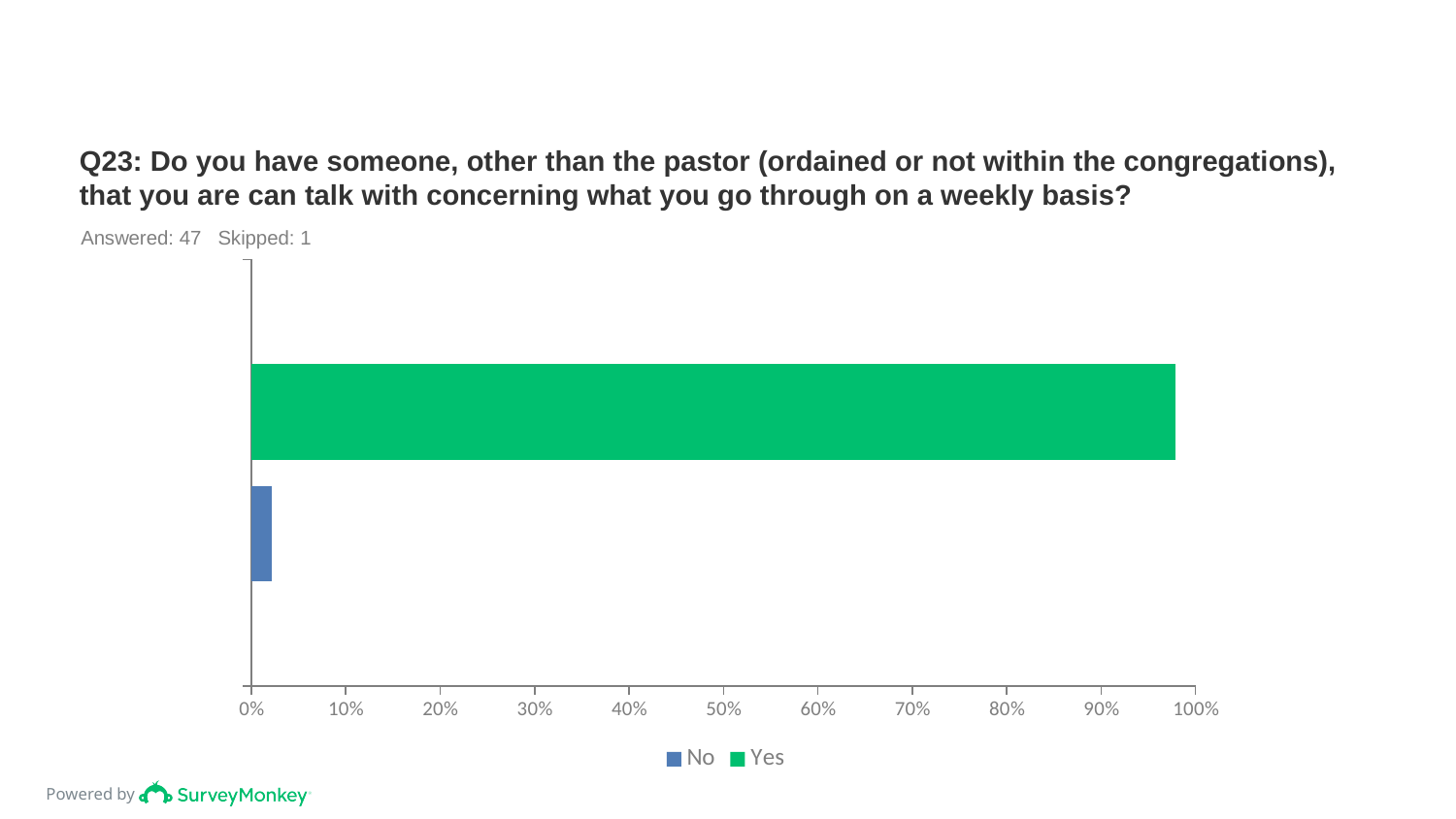
Is the value for Yes greater or less than 90%? greater Which series has the shortest bar, No or Yes? No Is the value for Yes greater or less than 50%? greater How many respondents answered this question according to the slide? 47 What colour is the bar for the Yes series? green Is the bar for Yes longer or shorter than the bar for No? longer What kind of chart is shown on the slide? bar chart Which series has the longest bar, No or Yes? Yes How many bars are plotted on the chart? 2 How many series does the legend list? 2 Is the value for No greater or less than 10%? less